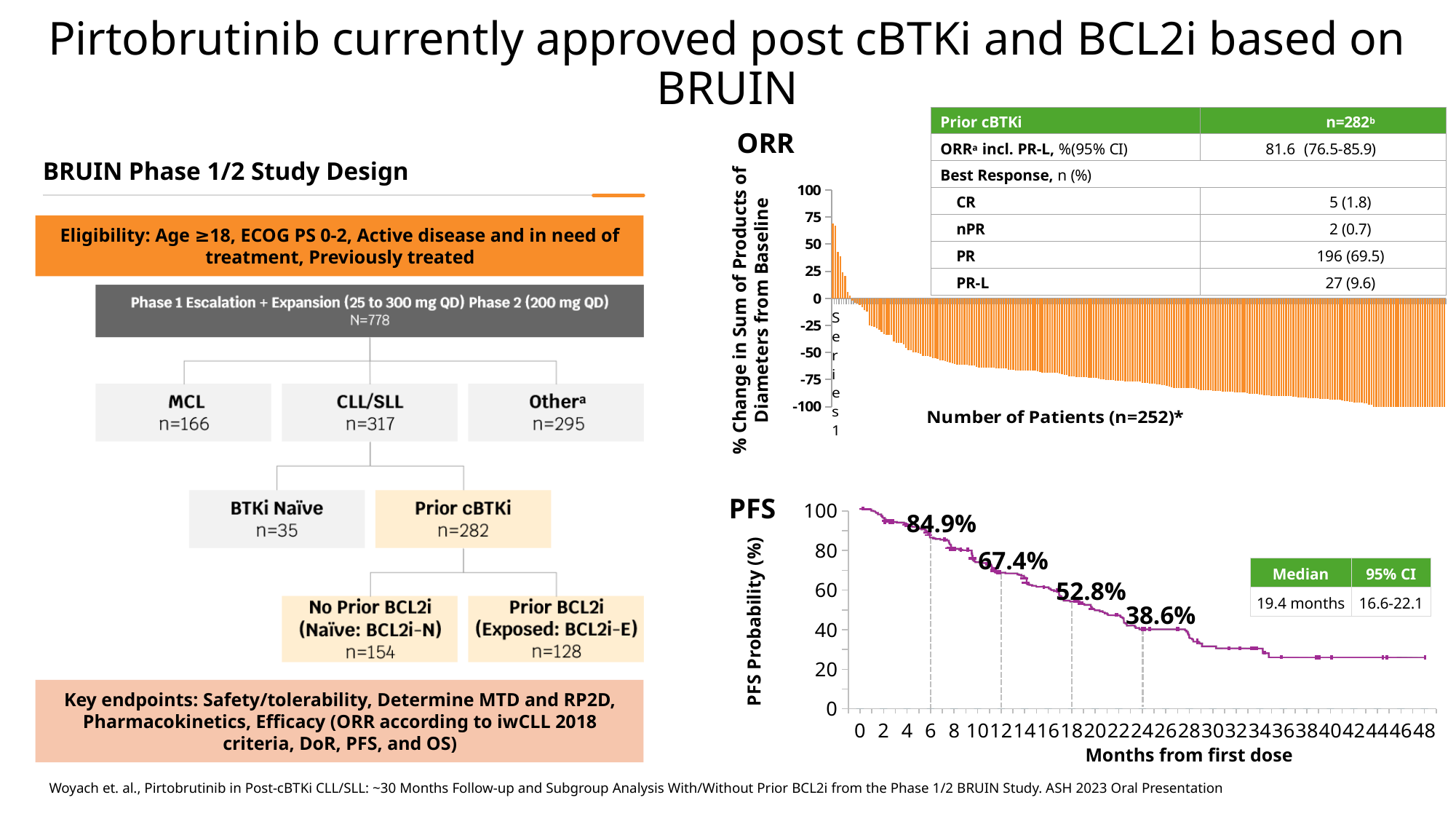
On the PFS chart, does the PFS probability rise or fall as months from first dose increase? fall On the PFS chart, how many percentage data labels are printed on the curve? 4 On the PFS chart, what is the PFS probability labelled at 24 months? 38.6% On the PFS chart, is the PFS probability at 36 months greater or less than 40? less On the PFS chart, what is the PFS probability labelled at 6 months? 84.9% What kind of chart is the PFS chart on the slide? line chart What kind of chart is the ORR chart on the slide? bar chart On the PFS chart, which labelled value is the lowest? 38.6% On the PFS chart, what is the difference between the labelled values at 18 months and 24 months? 14.2 percentage points On the ORR chart, what is the x-axis title? Number of Patients (n=252)* On the ORR chart, what is the highest tick value shown on the y-axis? 100 On the PFS chart, what is the difference between the labelled values at 6 months and 12 months? 17.5 percentage points